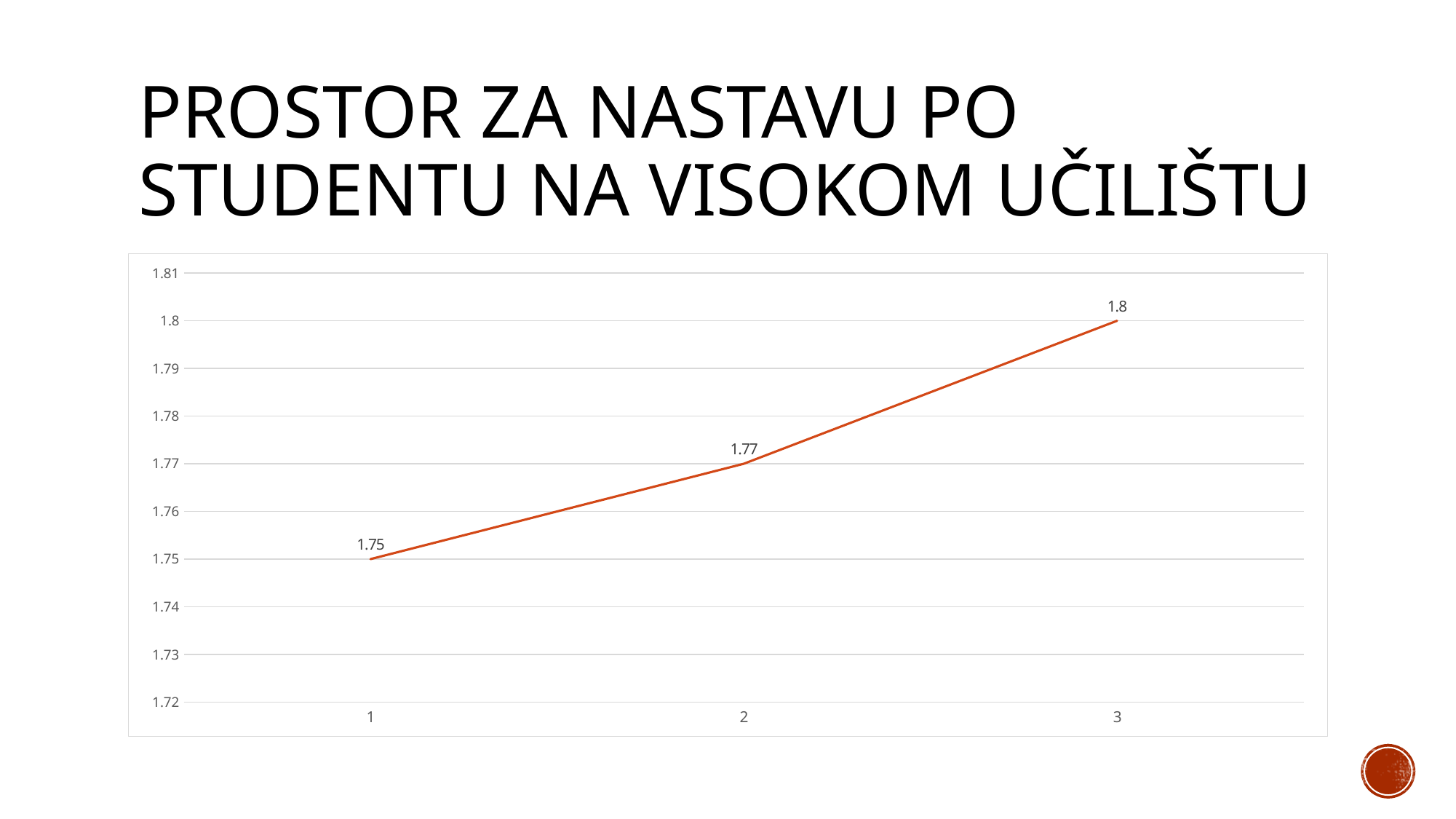
At which x value is the plotted value highest? 3 What is the difference between the values at x = 3 and x = 1? 0.05 What is the difference between the values at x = 2 and x = 1? 0.02 How many data points are plotted on the line? 3 Which is larger, the value at x = 2 or the value at x = 3? x = 3 At which x value is the plotted value lowest? 1 What is the value at x = 2? 1.77 What kind of chart is shown on the slide? line chart Is the value at x = 2 greater or less than 1.76? greater What is the value at x = 1? 1.75 Do the values rise or fall from x = 1 to x = 3? rise What is the value at x = 3? 1.8